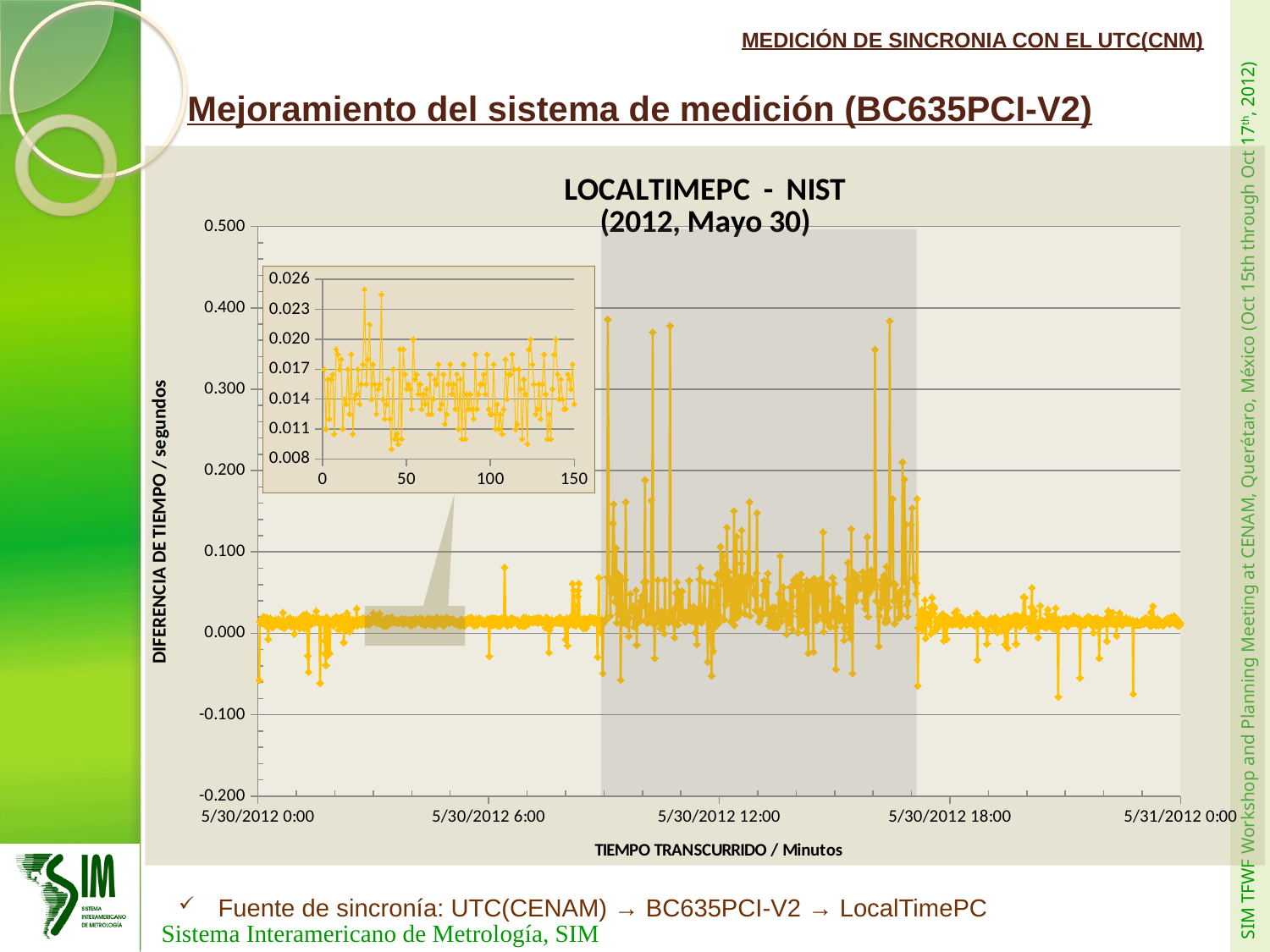
In the inset chart, what is the highest value shown on the vertical axis? 0.026 Is the lowest point in the main chart greater or less than -0.100? greater What is the lowest value shown on the vertical axis of the main chart? -0.200 What is the label of the vertical axis of the main chart? DIFERENCIA DE TIEMPO / segundos What is the title of the main chart? LOCALTIMEPC - NIST (2012, Mayo 30) What is the first date-time label on the horizontal axis of the main chart? 5/30/2012 0:00 Is the highest peak in the main chart greater or less than 0.300? greater In the inset chart, what is the last tick label on the horizontal axis? 150 What is the highest value shown on the vertical axis of the main chart? 0.500 What kind of chart is shown on the slide? line chart Is the highest peak in the main chart greater or less than 0.400? less What is the last date-time label on the horizontal axis of the main chart? 5/31/2012 0:00